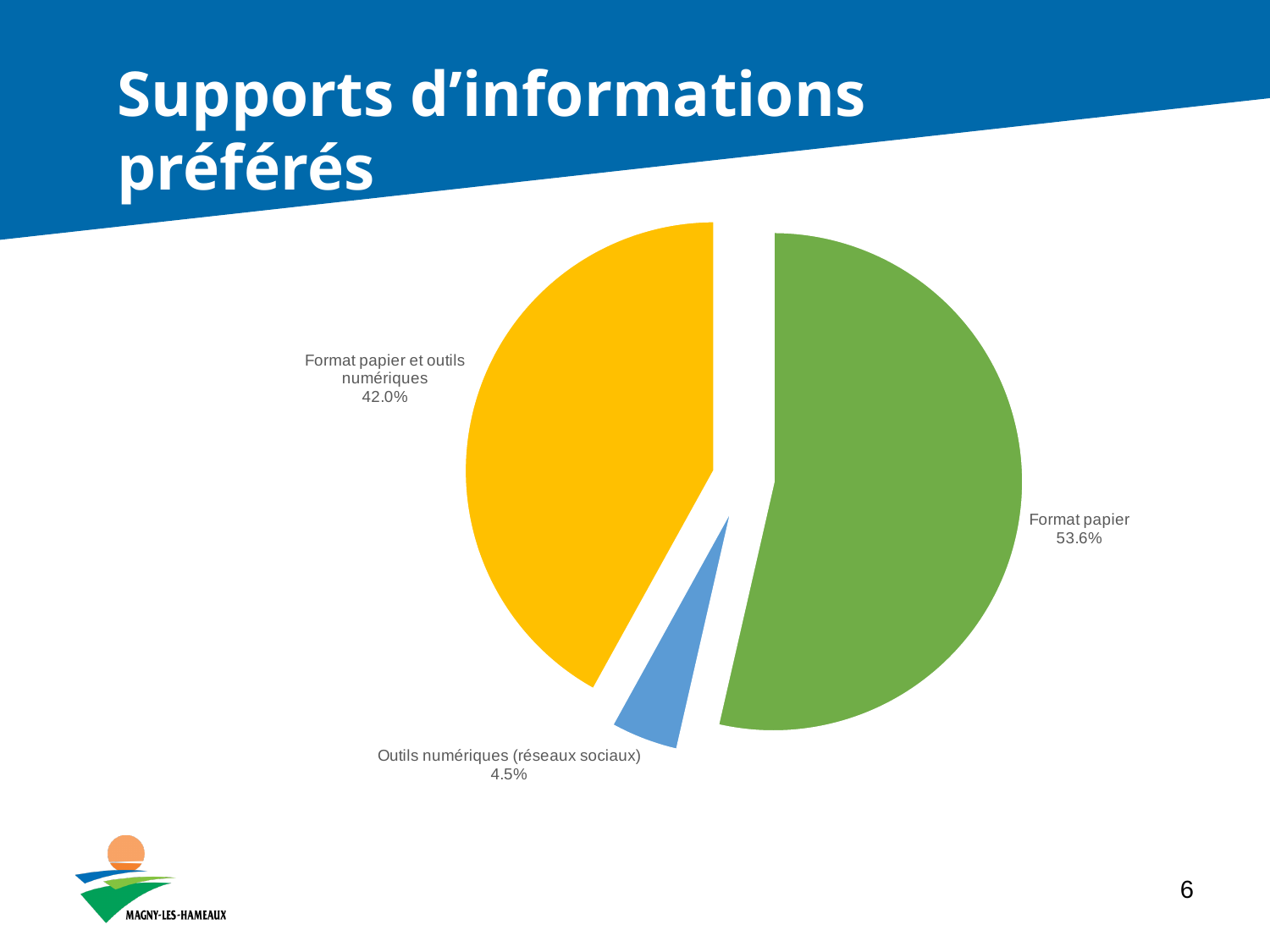
What is the difference in percentage points between "Format papier" and "Format papier et outils numériques"? 11.6 Which category has the largest slice of the pie? Format papier How many slices does the pie chart have? 3 What is the title of the slide containing the pie chart? Supports d’informations préférés What share of the pie does "Format papier" represent? 53.6% Which is larger: the share for "Format papier et outils numériques" or the share for "Outils numériques (réseaux sociaux)"? Format papier et outils numériques What colour is the "Format papier" slice? green What share of the pie does "Outils numériques (réseaux sociaux)" represent? 4.5% What share of the pie does "Format papier et outils numériques" represent? 42.0% What is the difference in percentage points between "Format papier et outils numériques" and "Outils numériques (réseaux sociaux)"? 37.5 Which category has the smallest slice of the pie? Outils numériques (réseaux sociaux) What kind of chart is shown on the slide? pie chart